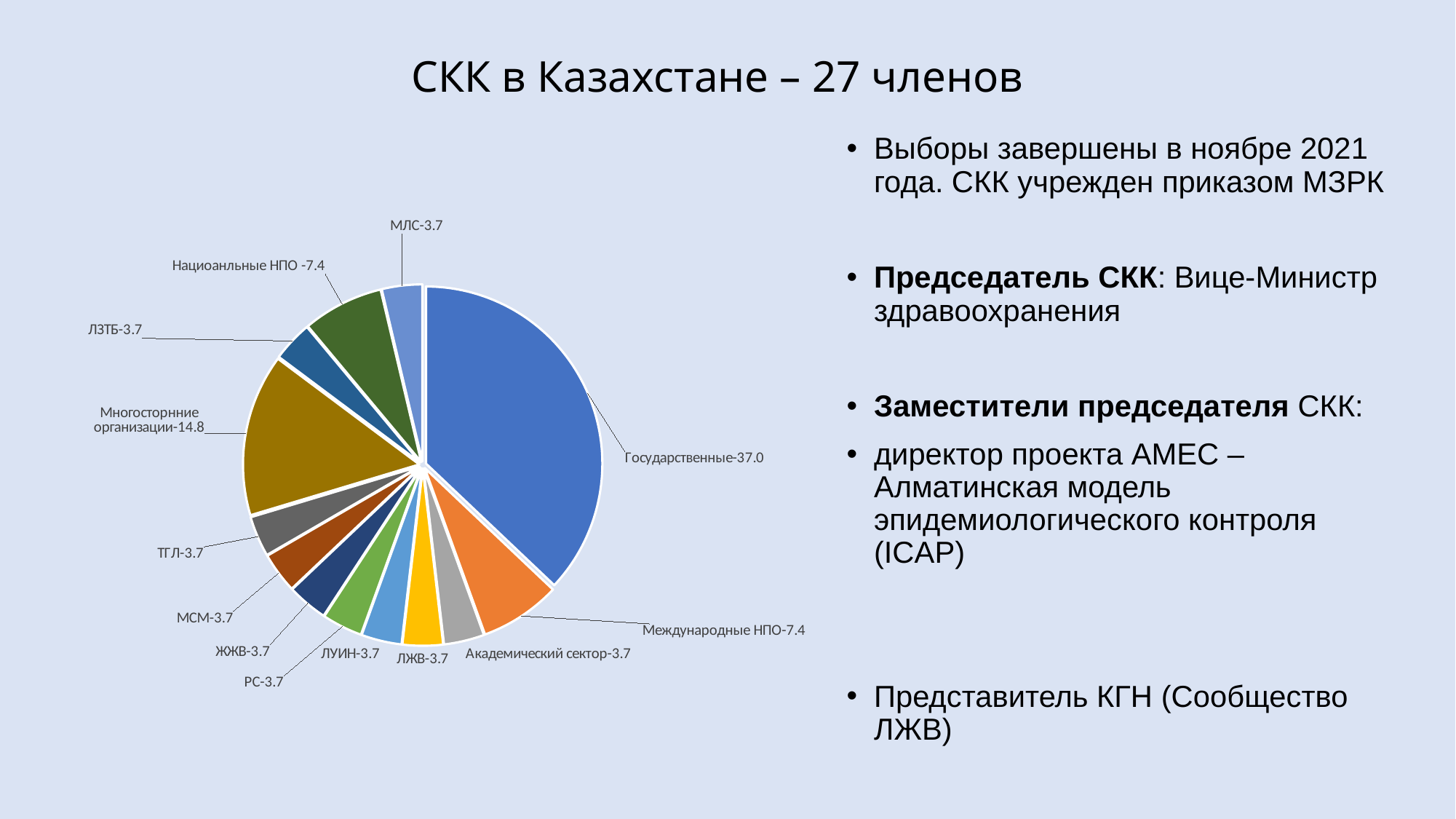
What is the difference between the values for Международные НПО and ЛЖВ? 3.7 What is the value shown for Академический сектор? 3.7 What is the value shown for Государственные? 37.0 Which category has the largest slice of the pie? Государственные What is the value shown for Нациоанльные НПО? 7.4 What is the title of the slide containing the chart? СКК в Казахстане – 27 членов Which is larger, the value for Многосторнние организации or the value for Международные НПО? Многосторнние организации What is the difference between the values for Государственные and Многосторнние организации? 22.2 What kind of chart is shown on the slide? pie chart What is the value shown for Международные НПО? 7.4 How many slices does the pie chart have? 13 What is the value shown for Многосторнние организации? 14.8